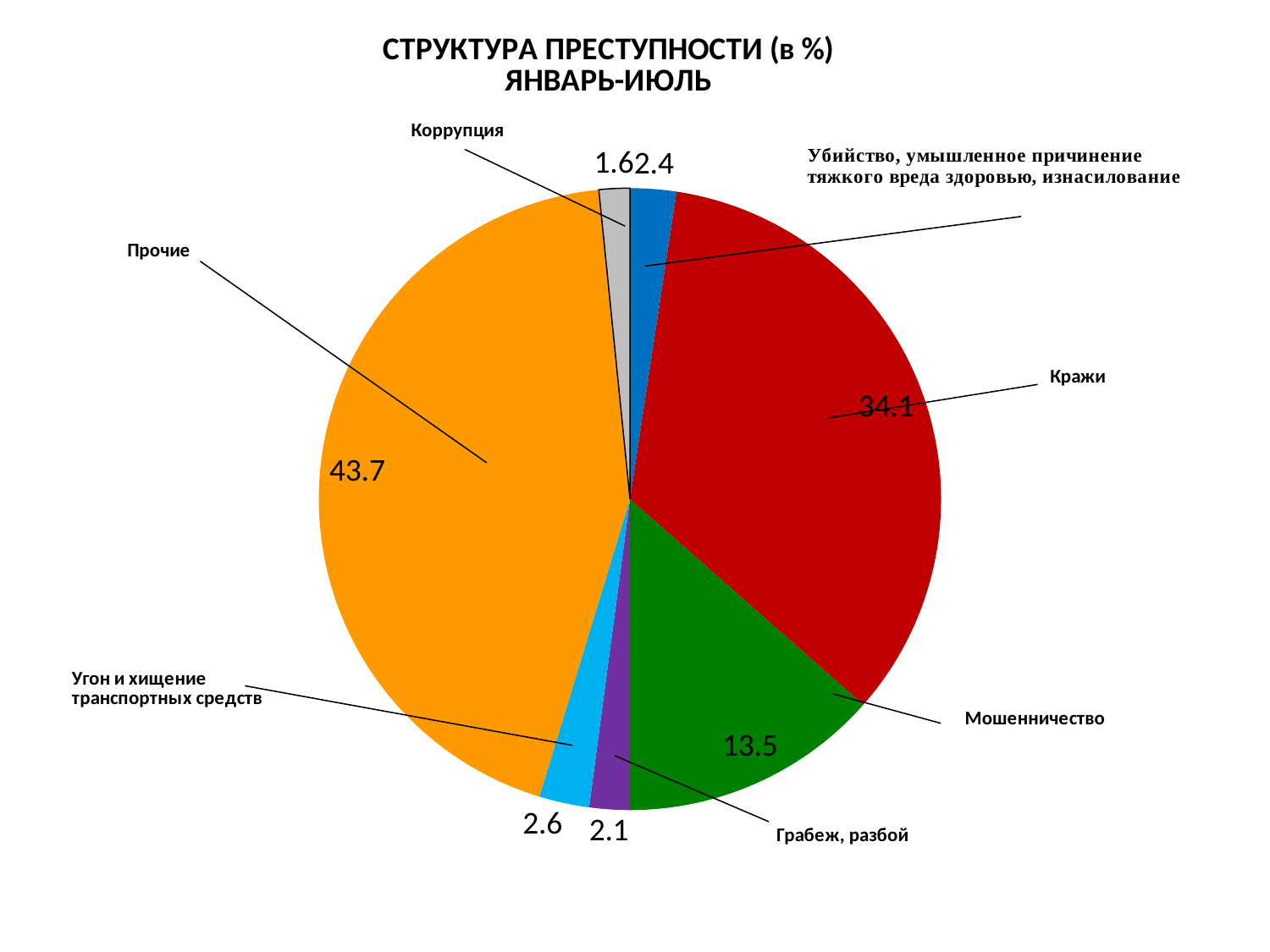
What is the title of the chart? СТРУКТУРА ПРЕСТУПНОСТИ (в %) ЯНВАРЬ-ИЮЛЬ Which is larger, the value for Мошенничество or the value for Угон и хищение транспортных средств? Мошенничество What is the difference between the values for Прочие and Кражи? 9.6 How many categories (slices) does the pie chart have? 7 What is the value for Мошенничество? 13.5 What kind of chart is shown on the slide? pie chart What is the value for Угон и хищение транспортных средств? 2.6 What is the value for Грабеж, разбой? 2.1 What is the value for Прочие? 43.7 What is the value for Кражи? 34.1 Which category has the smallest slice of the pie? Коррупция Which category has the largest slice of the pie? Прочие